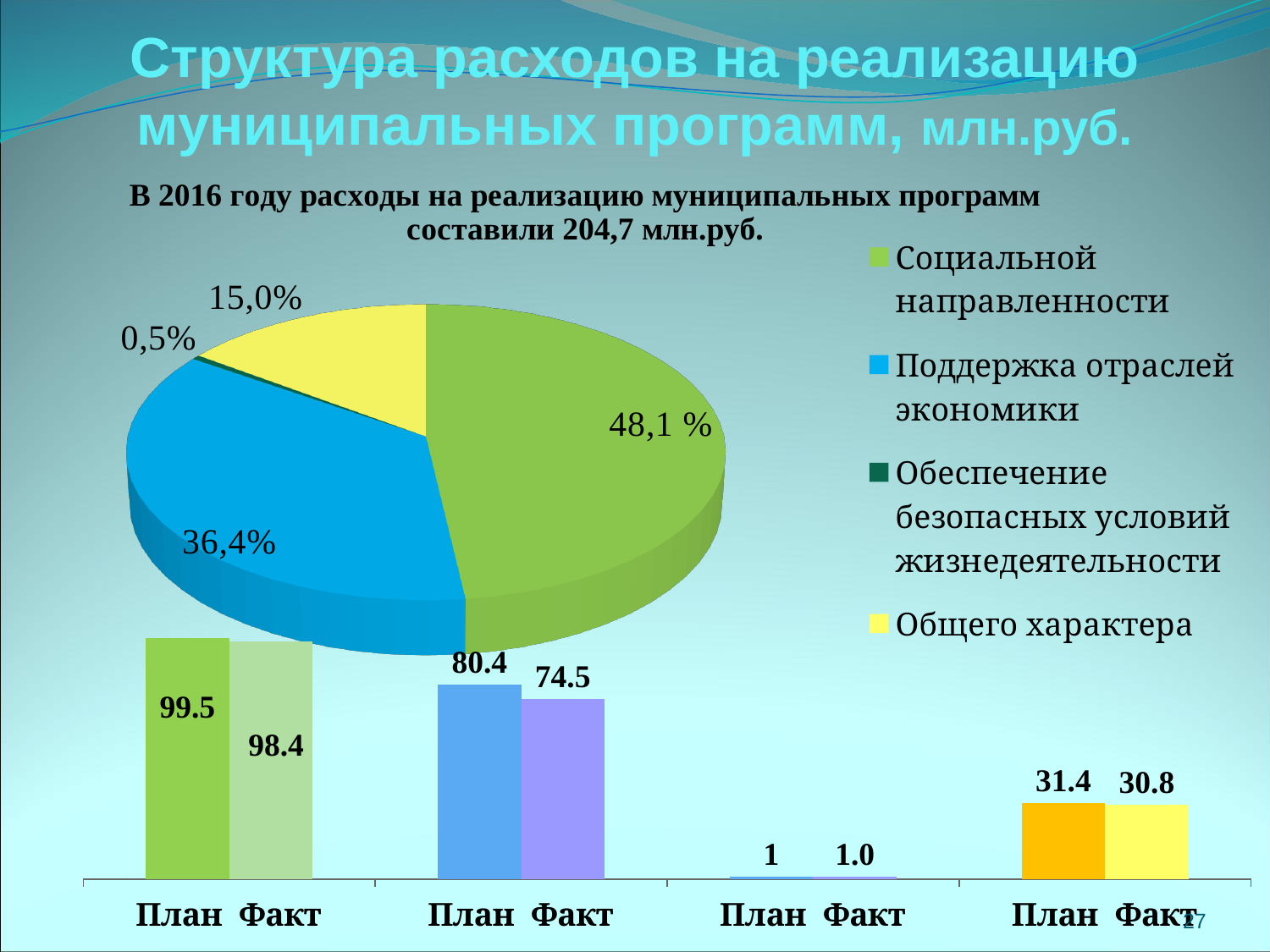
In the bar chart at the bottom, what is the План value in the first group from the left? 99.5 What kind of chart is the lower chart on the slide? bar chart How many categories does the pie chart's legend list? 4 In the bar chart at the bottom, which is larger in the fourth group from the left, План or Факт? План In the pie chart, which category has the smallest slice? Обеспечение безопасных условий жизнедеятельности In the bar chart at the bottom, what is the difference between План and Факт in the second group from the left? 5.9 In the pie chart, what share is shown for Социальной направленности? 48,1 % In the pie chart, which category has the largest slice? Социальной направленности In the pie chart, what share is shown for Общего характера? 15,0% In the bar chart at the bottom, what is the Факт value in the second group from the left? 74.5 In the pie chart, what share is shown for Поддержка отраслей экономики? 36,4% What kind of chart is the upper chart on the slide? pie chart